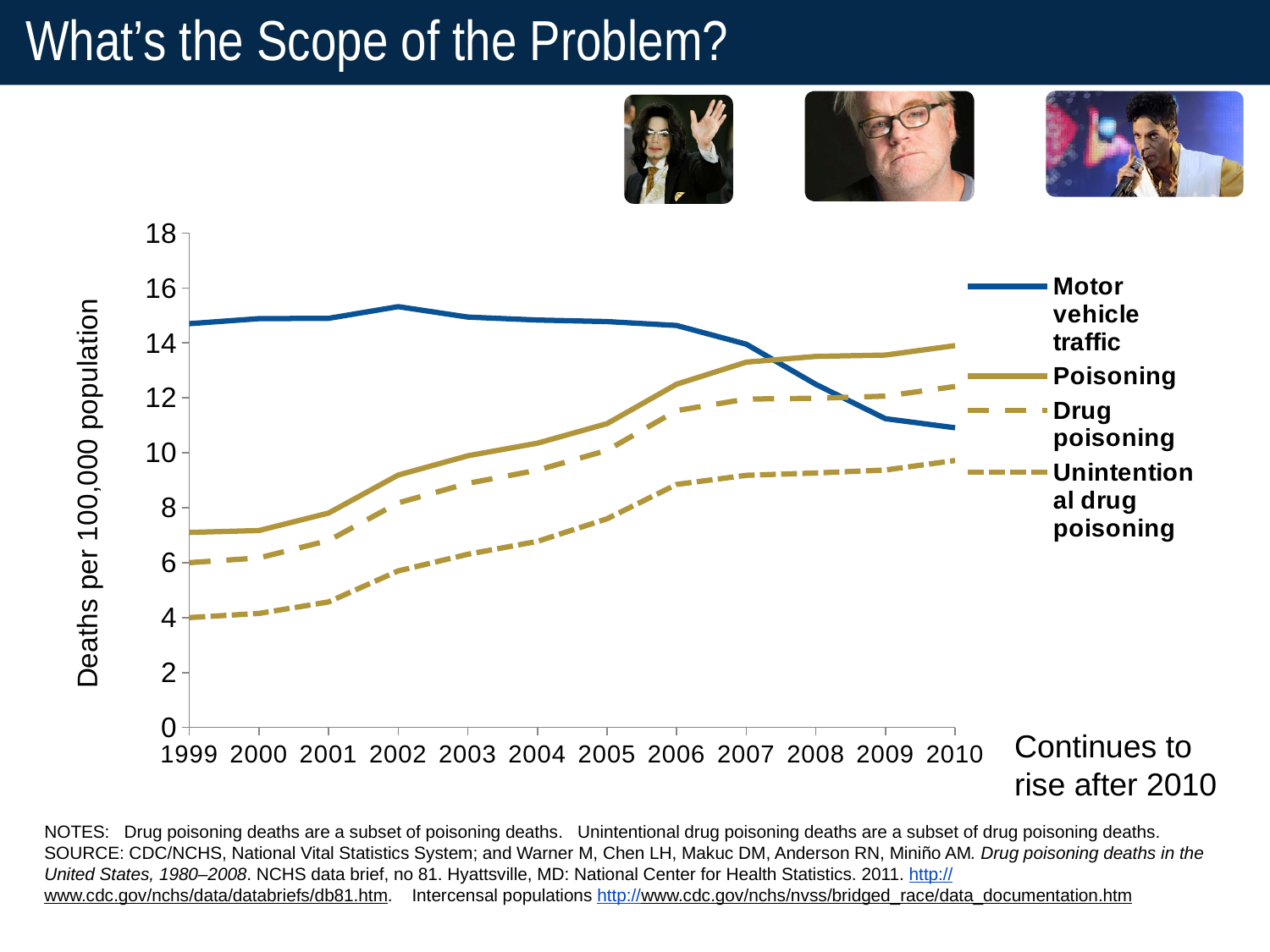
How many years are shown along the x axis of the chart? 12 Does the Poisoning series rise or fall from 1999 to 2010? Rise Which series is drawn as a solid blue line in the chart? Motor vehicle traffic How many series does the chart's legend list? 4 Does the Motor vehicle traffic series rise or fall overall from 1999 to 2010? Fall Is the value for Unintentional drug poisoning in 1999 greater or less than 6? less What is the label of the chart's vertical axis? Deaths per 100,000 population In 2010, which is larger: Poisoning or Motor vehicle traffic? Poisoning Is the value for Motor vehicle traffic in 2010 greater or less than 12? less Which series has the lowest value in 2010? Unintentional drug poisoning Which series has the highest value in 1999? Motor vehicle traffic What kind of chart is shown on the slide? Line chart